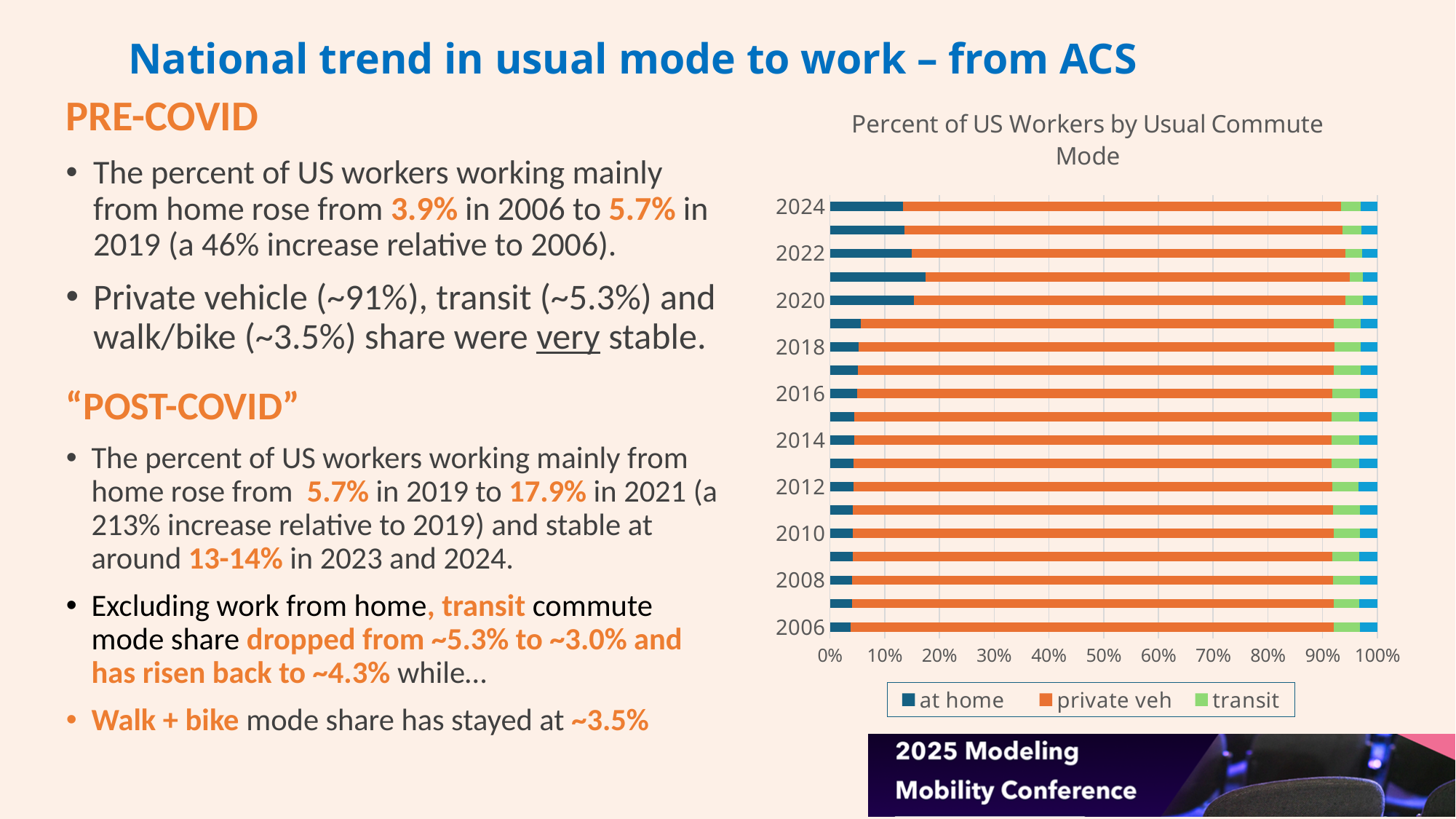
Does the 'at home' share generally rise or fall from 2006 to 2024? rise How many series does the chart legend list? 3 Which year has a larger 'at home' share, 2006 or 2024? 2024 What kind of chart is shown on the slide? stacked bar chart What is the title of the chart? Percent of US Workers by Usual Commute Mode Is the 'private veh' share for 2006 greater or less than 80%? greater Which year has the longest 'at home' segment? 2021 How many bars (years) are plotted in the chart? 19 What colour represents 'transit' in the chart? green Is the 'at home' share for 2024 greater or less than 10%? greater Which year has a larger 'private veh' share, 2006 or 2022? 2006 Is the 'at home' share for 2006 greater or less than 10%? less